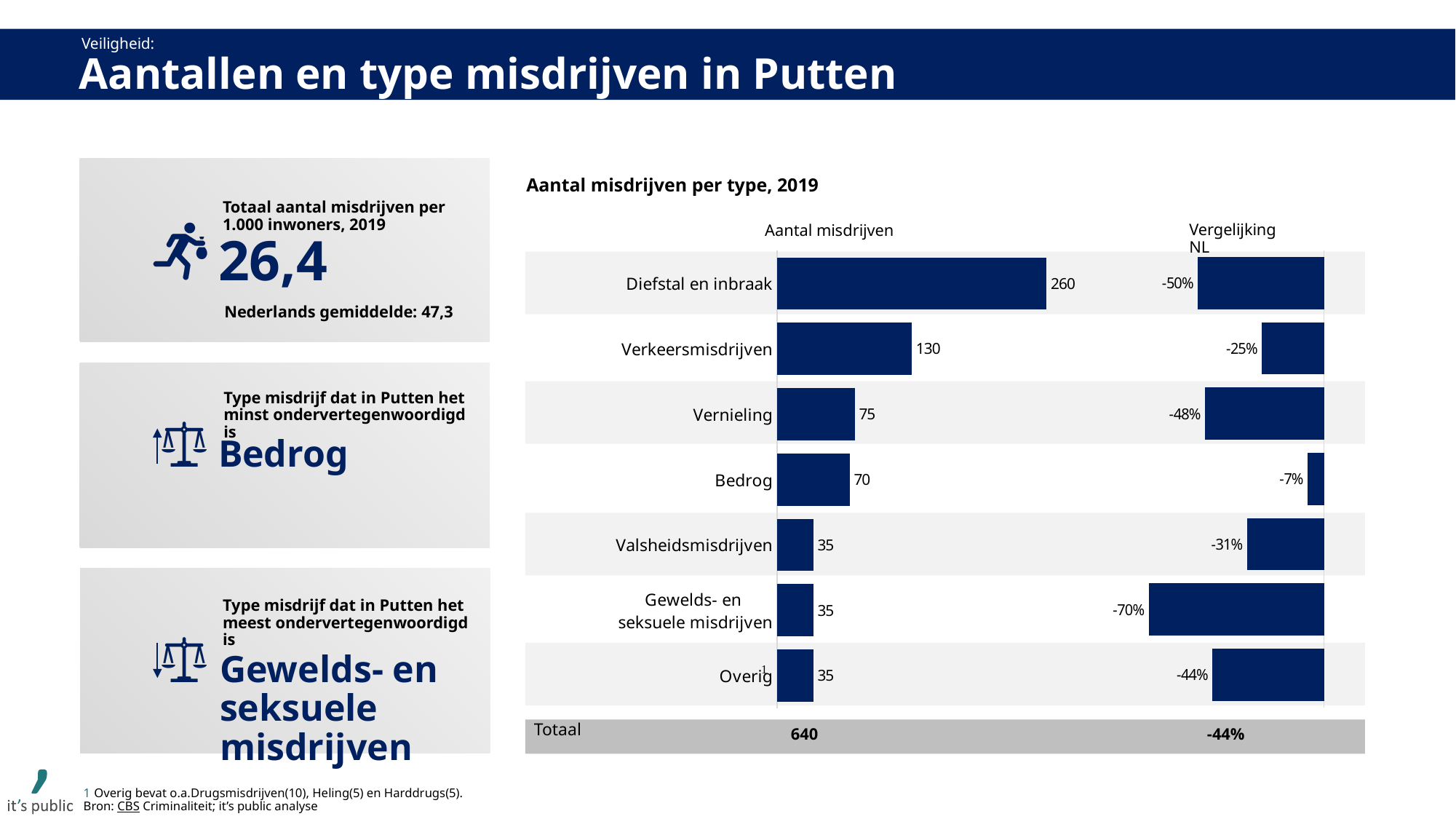
In the chart 'Aantal misdrijven per type, 2019', what is the Totaal value for 'Aantal misdrijven'? 640 In the chart 'Aantal misdrijven per type, 2019', which crime type has the highest 'Aantal misdrijven'? Diefstal en inbraak In the chart 'Aantal misdrijven per type, 2019', how many crime types are listed (excluding the Totaal row)? 7 In the chart 'Aantal misdrijven per type, 2019', what is the 'Aantal misdrijven' value for Verkeersmisdrijven? 130 In the chart 'Aantal misdrijven per type, 2019', which has a higher 'Aantal misdrijven': Vernieling or Bedrog? Vernieling In the chart 'Aantal misdrijven per type, 2019', what is the difference in 'Aantal misdrijven' between Diefstal en inbraak and Verkeersmisdrijven? 130 What kind of chart is 'Aantal misdrijven per type, 2019'? bar chart In the chart 'Aantal misdrijven per type, 2019', what is the 'Vergelijking NL' value for Bedrog? -7% In the chart 'Aantal misdrijven per type, 2019', which crime type has the 'Vergelijking NL' value closest to zero? Bedrog In the chart 'Aantal misdrijven per type, 2019', what is the Totaal value for 'Vergelijking NL'? -44% In the chart 'Aantal misdrijven per type, 2019', what is the 'Vergelijking NL' value for Gewelds- en seksuele misdrijven? -70% In the chart 'Aantal misdrijven per type, 2019', what is the 'Aantal misdrijven' value for Diefstal en inbraak? 260